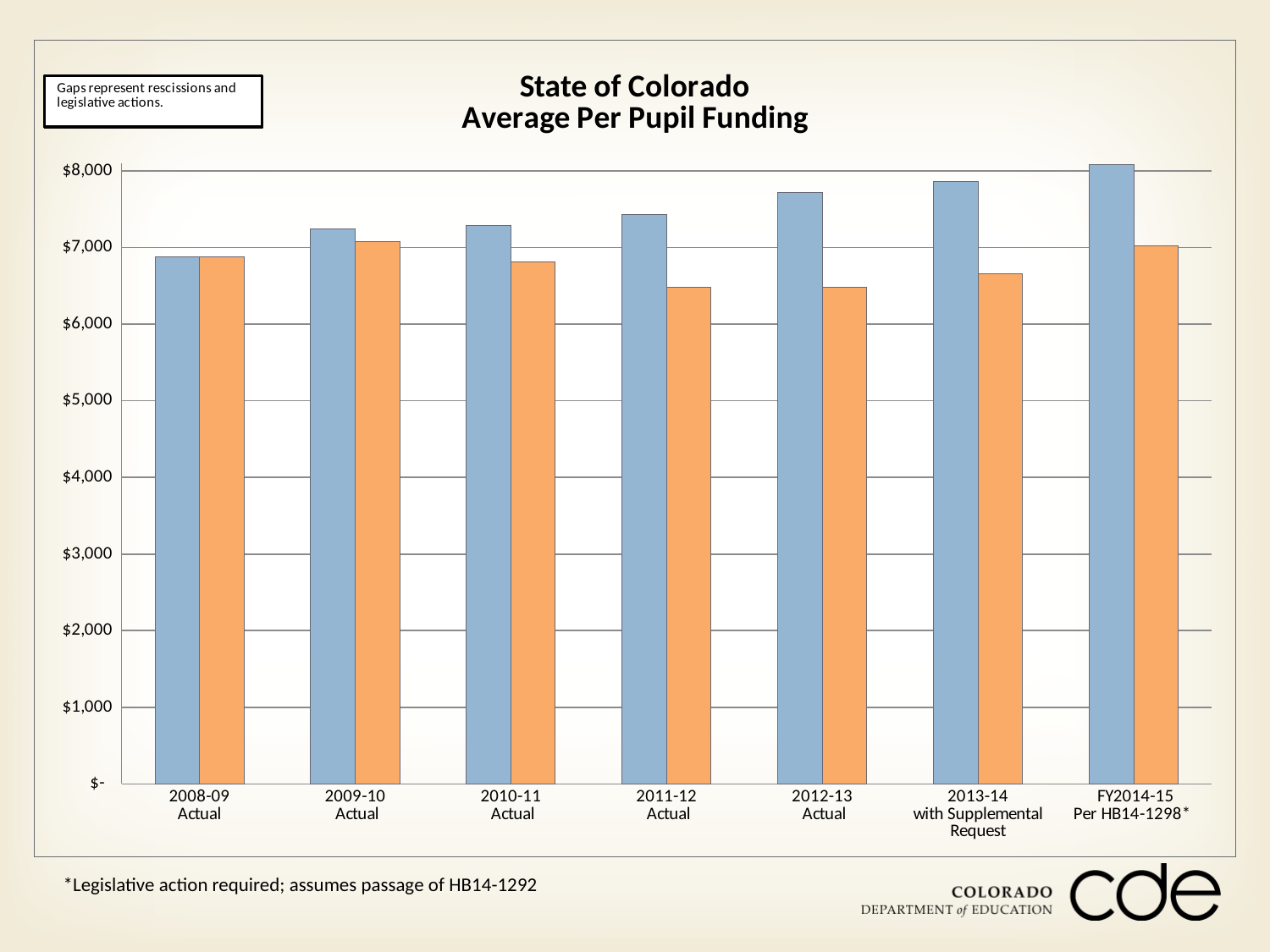
Is the blue bar for FY2014-15 Per HB14-1298* greater or less than $8,000? greater What kind of chart is shown on the slide? bar chart Is the orange bar for 2011-12 Actual greater or less than $7,000? less Which category has the shortest blue bar? 2008-09 Actual Is the orange bar for 2013-14 with Supplemental Request greater or less than $7,000? less For 2013-14 with Supplemental Request, which bar is taller, the blue or the orange? blue What is the title of the chart? State of Colorado Average Per Pupil Funding Do the blue bars rise or fall from 2008-09 to FY2014-15? rise Which orange bar is taller, 2009-10 Actual or 2010-11 Actual? 2009-10 Actual How many fiscal-year categories are shown on the x axis? 7 Which category has the tallest blue bar? FY2014-15 Per HB14-1298*